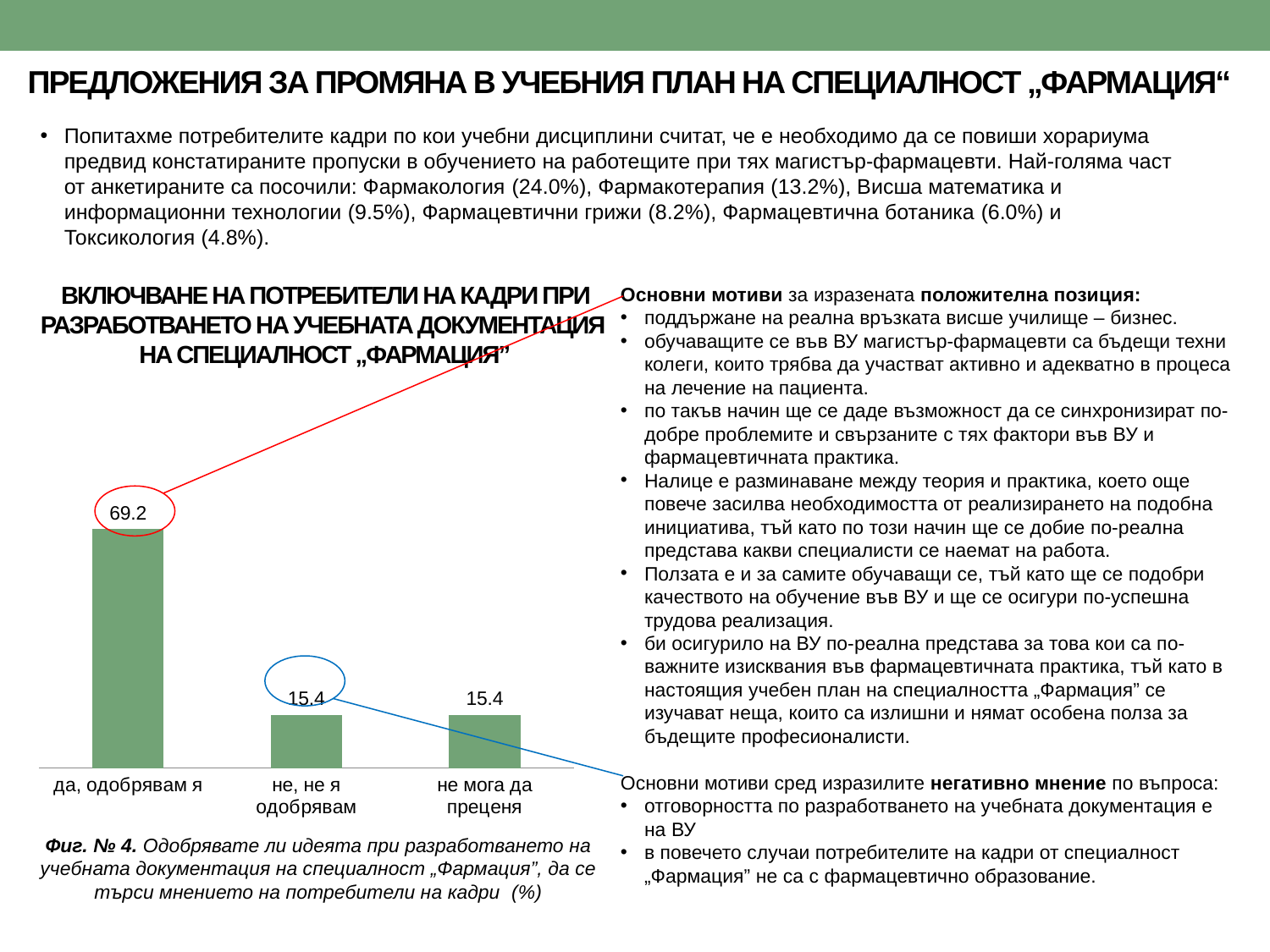
How many categories are shown on the x axis of the chart? 3 Which category has the highest value? да, одобрявам я What kind of chart is shown on the slide? bar chart What is the value for "не мога да преценя"? 15.4 What is the value for "да, одобрявам я"? 69.2 What is the difference between the values for "да, одобрявам я" and "не, не я одобрявам"? 53.8 What is the value for "не, не я одобрявам"? 15.4 Do the values rise or fall from the first category to the second category along the x axis? fall Which is larger, the value for "да, одобрявам я" or the value for "не мога да преценя"? да, одобрявам я What colour are the bars in the chart? green Which data label on the chart is circled in red? 69.2